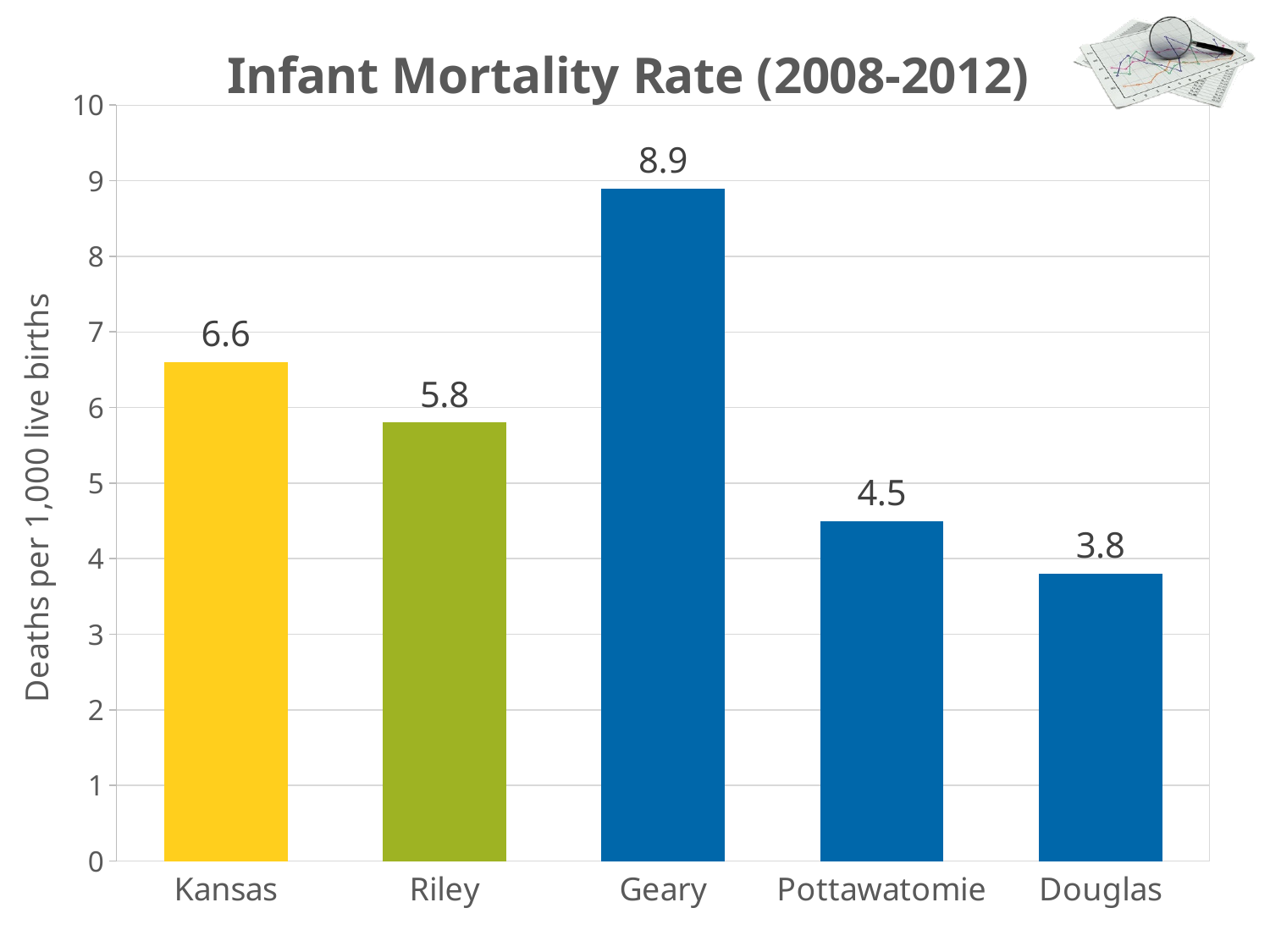
What is the difference between the infant mortality rates of Geary and Kansas? 2.3 What is the infant mortality rate for Kansas? 6.6 Is the value for Pottawatomie greater or less than 5? less What kind of chart is shown on the slide? Bar chart What is the difference between the infant mortality rates of Riley and Pottawatomie? 1.3 Which has a higher infant mortality rate, Riley or Pottawatomie? Riley Which category has the lowest infant mortality rate? Douglas What is the title of the chart? Infant Mortality Rate (2008-2012) How many categories are shown on the chart? 5 What is the infant mortality rate for Geary? 8.9 What is the infant mortality rate for Douglas? 3.8 Which category has the highest infant mortality rate? Geary